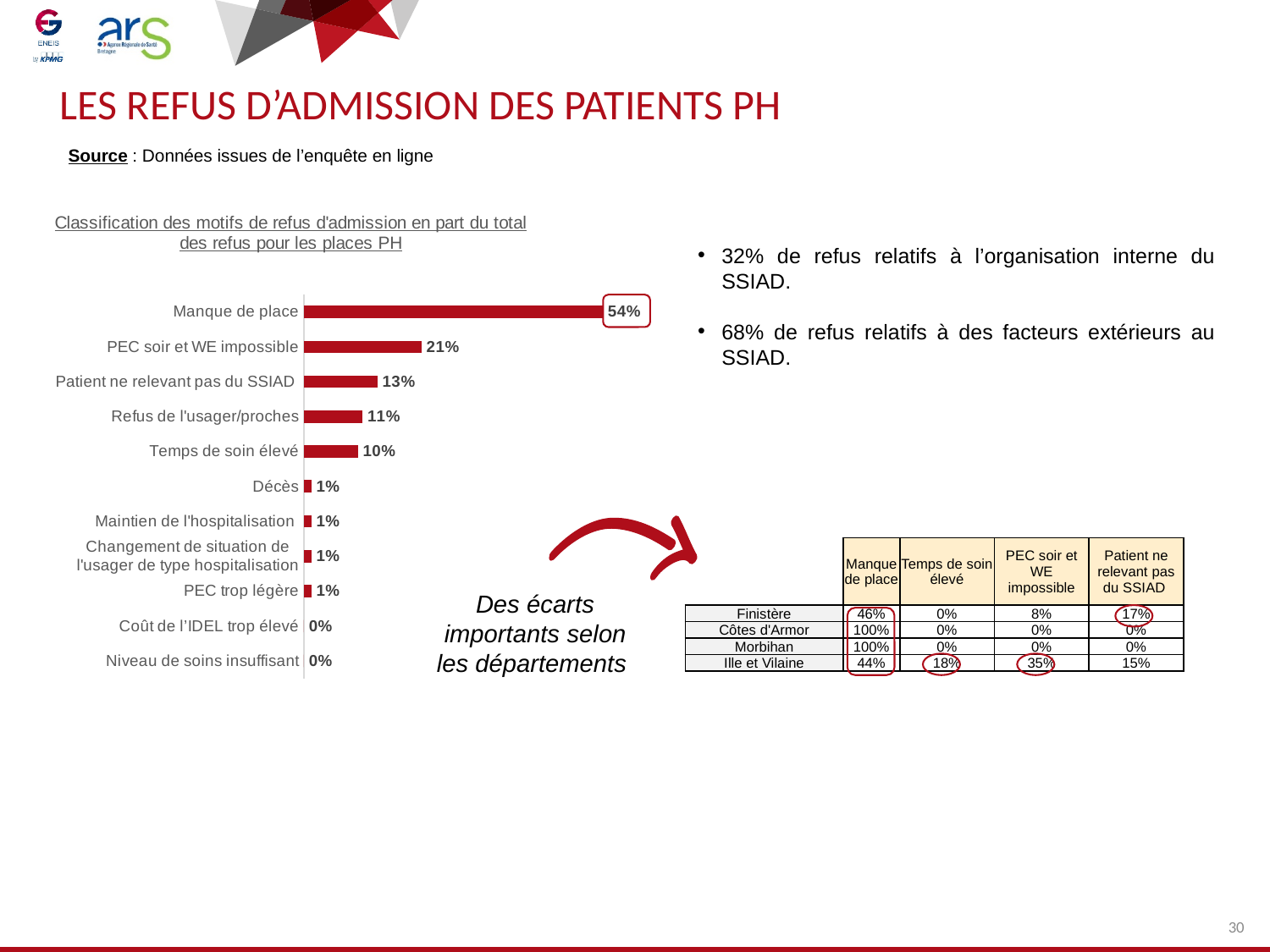
How many categories are shown in the bar chart? 11 What is the value for "Manque de place"? 54% Which is larger, "Patient ne relevant pas du SSIAD" or "Refus de l'usager/proches"? Patient ne relevant pas du SSIAD What is the title of the bar chart? Classification des motifs de refus d'admission en part du total des refus pour les places PH What type of chart is shown on the slide? Bar chart How many categories have a value of 0%? 2 Which category has the highest value? Manque de place What is the difference between "Manque de place" and "PEC soir et WE impossible"? 33% What is the difference between "Patient ne relevant pas du SSIAD" and "Temps de soin élevé"? 3% What is the value for "Temps de soin élevé"? 10% What is the value for "Refus de l'usager/proches"? 11% What is the value for "PEC soir et WE impossible"? 21%